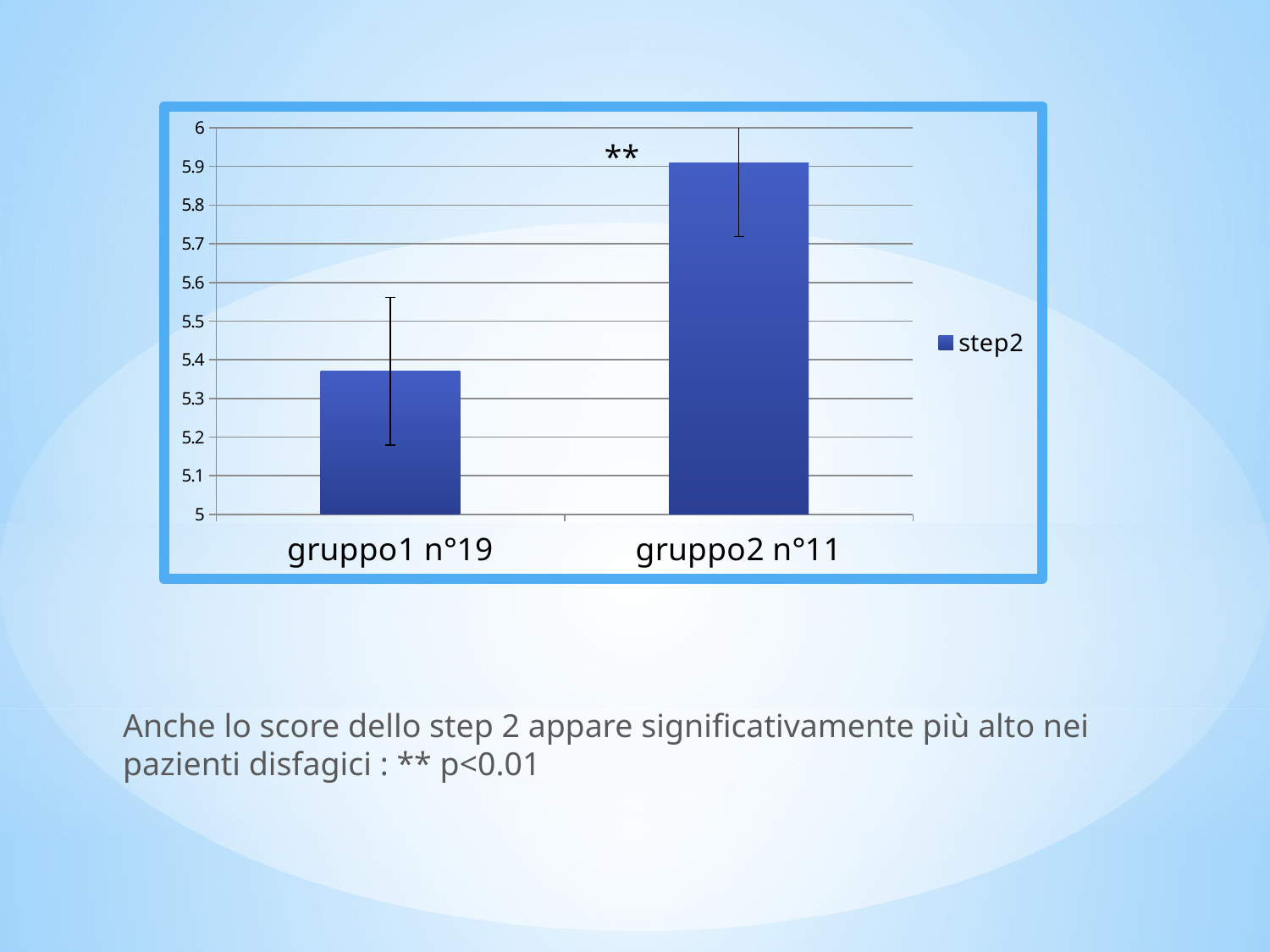
What kind of chart is shown on the slide? bar chart Which bar in the chart is marked with the annotation "**"? gruppo2 n°11 Which category has the highest step2 value? gruppo2 n°11 Which has a larger step2 value, gruppo1 n°19 or gruppo2 n°11? gruppo2 n°11 What is the name of the series shown in the chart's legend? step2 Is the step2 value for gruppo2 n°11 greater or less than 6? less Is the step2 value for gruppo2 n°11 greater or less than 5.8? greater Is the step2 value for gruppo1 n°19 greater or less than 5.5? less How many categories are shown on the x axis of the chart? 2 Which category has the lowest step2 value? gruppo1 n°19 How many series does the chart's legend list? 1